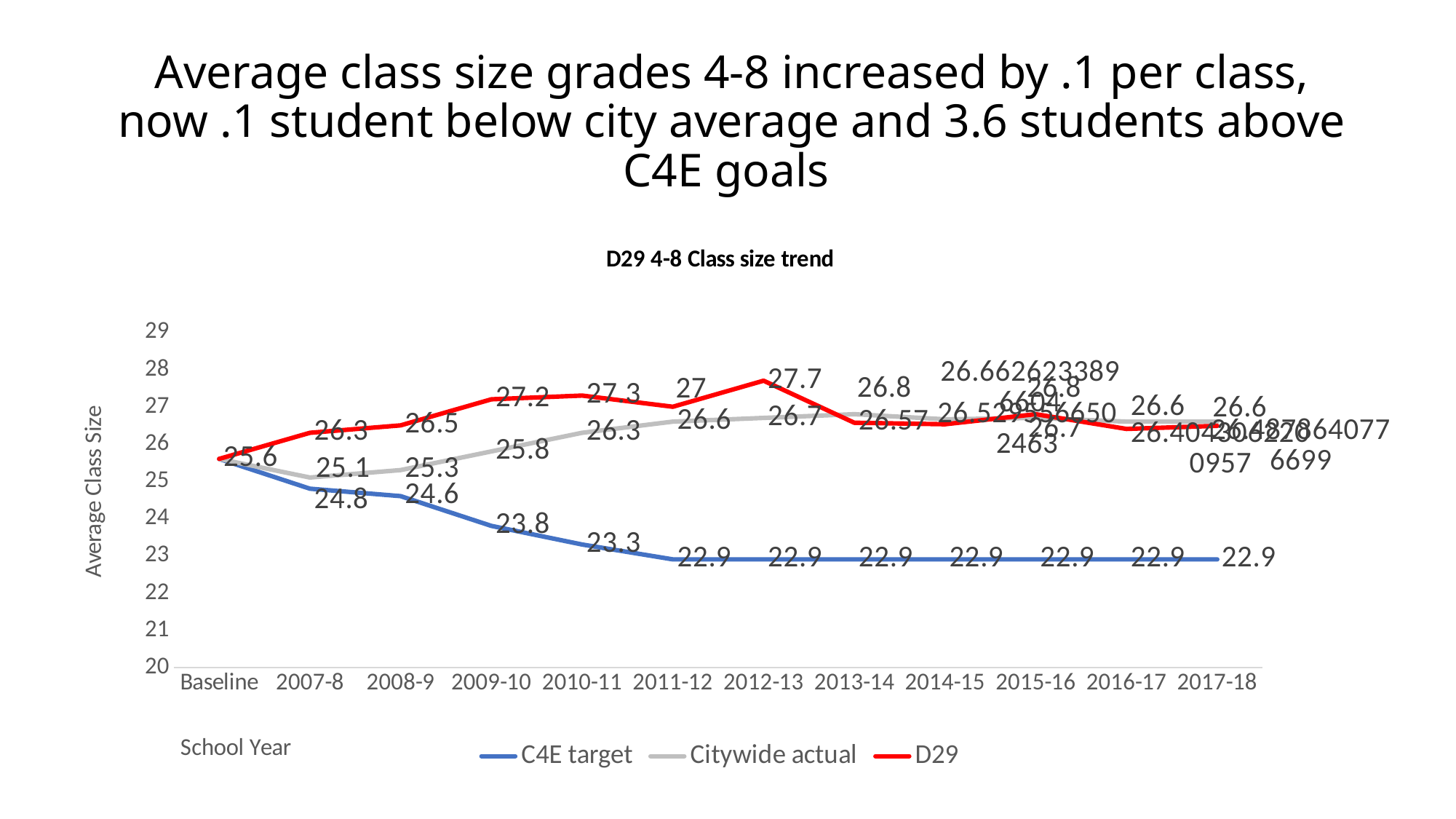
Is the Citywide actual value for 2015-16 greater or less than 26? greater In 2008-9, which is larger: the D29 value or the Citywide actual value? D29 Does the C4E target series rise or fall from Baseline to 2011-12? fall What is the C4E target value for 2009-10? 23.8 How many school years (points) are shown on the x axis? 12 What is the difference between the D29 value and the C4E target value in 2010-11? 4 What is the title of the chart? D29 4-8 Class size trend What kind of chart is shown on the slide? line chart How many series does the legend list? 3 What is the Citywide actual value for 2013-14? 26.8 What is the D29 value for 2012-13? 27.7 In which school year does the D29 series reach its highest value? 2012-13